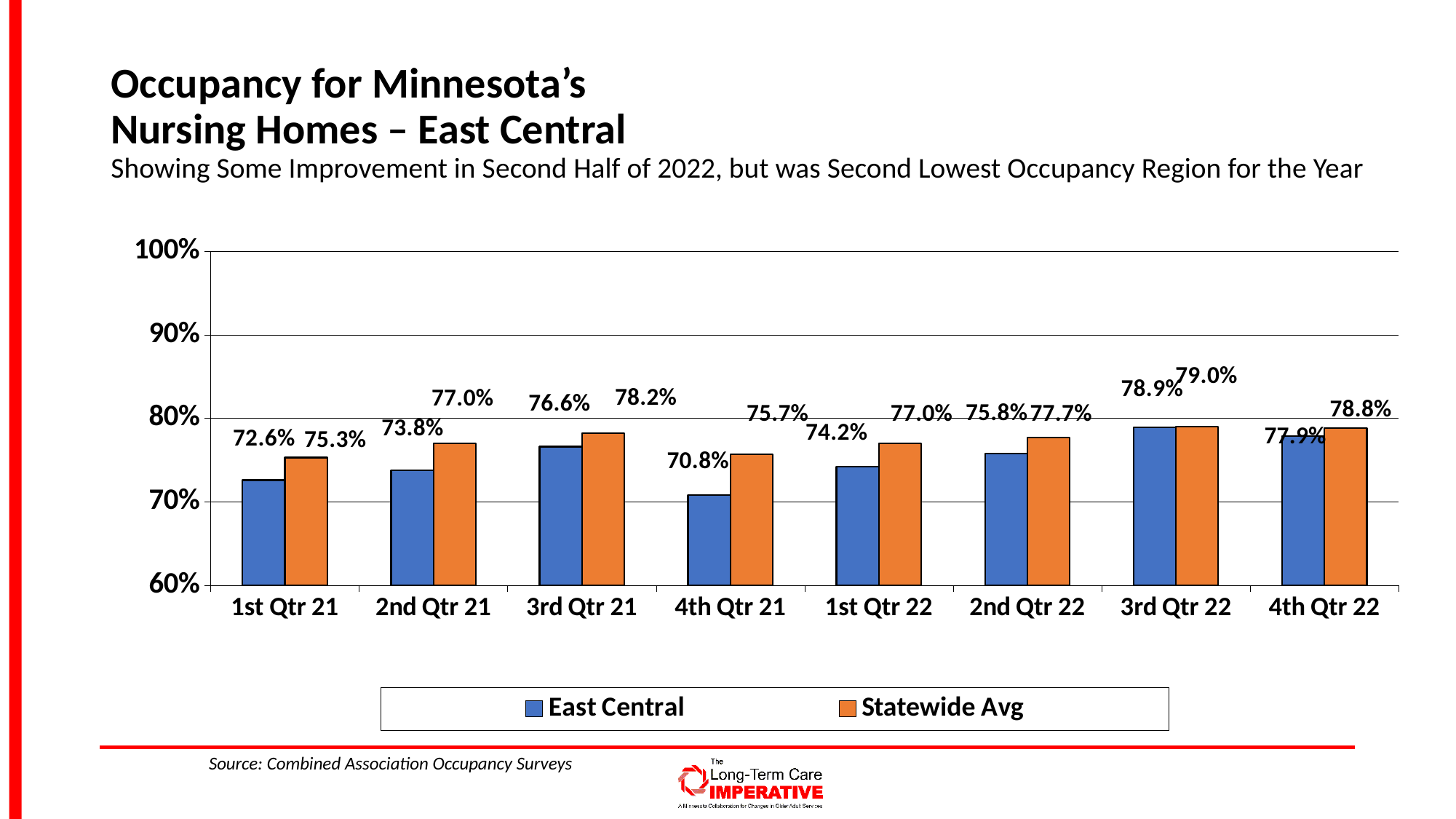
By how many percentage points does the Statewide Avg exceed East Central in 4th Qtr 22? 0.9 percentage points Does the East Central occupancy rise or fall from 4th Qtr 21 to 3rd Qtr 22? Rise In which quarter is the East Central occupancy highest? 3rd Qtr 22 In which quarter is the East Central occupancy lowest? 4th Qtr 21 What is the East Central occupancy value for 4th Qtr 21? 70.8% How many quarters are shown on the x axis? 8 By how many percentage points does the Statewide Avg exceed East Central in 1st Qtr 21? 2.7 percentage points How many series does the legend list? 2 What kind of chart is shown on the slide? Bar chart What is the Statewide Avg occupancy value for 3rd Qtr 21? 78.2% In which quarter is the Statewide Avg occupancy lowest? 1st Qtr 21 In 2nd Qtr 22, which is larger: East Central or Statewide Avg? Statewide Avg